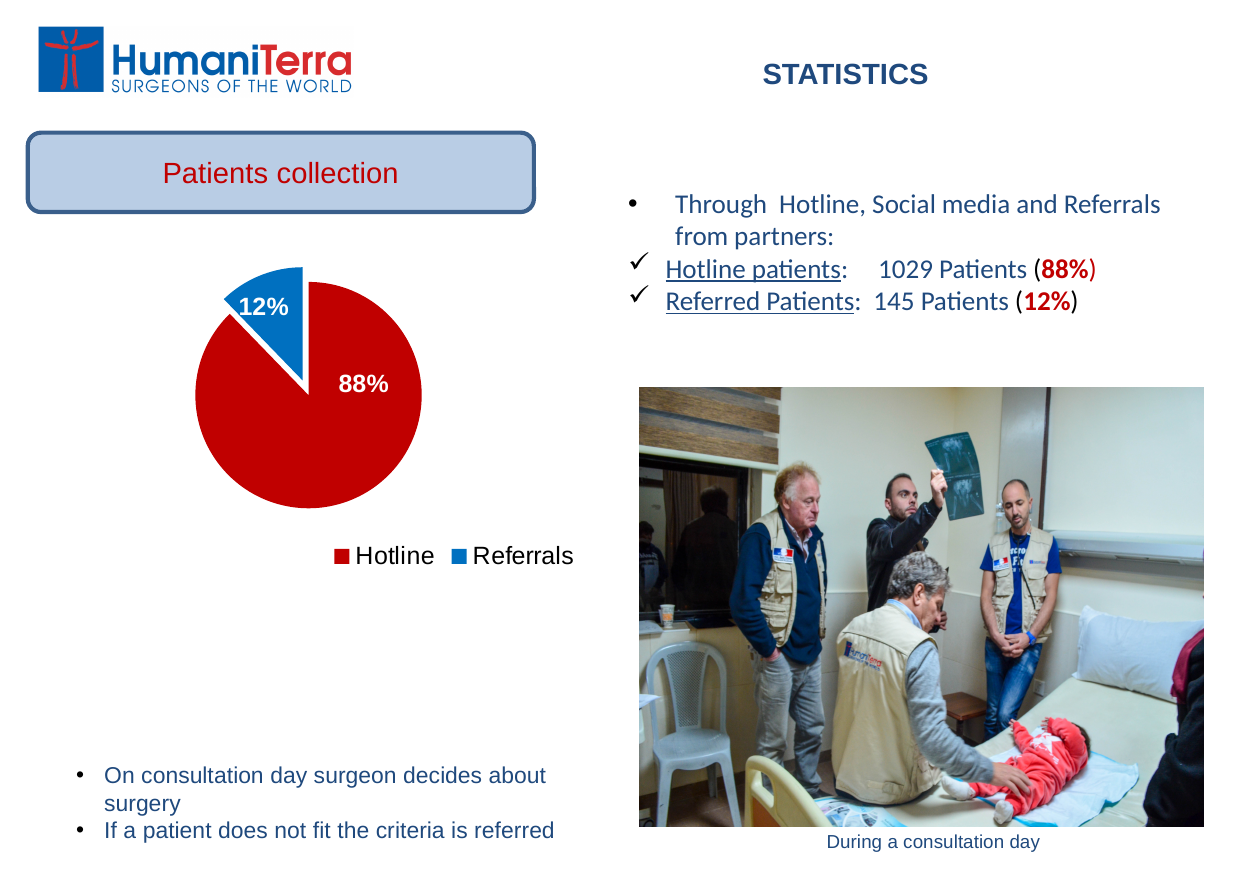
How many slices does the pie chart have? 2 Which slice of the pie is the largest? Hotline Which is larger, the Hotline slice or the Referrals slice? Hotline What colour is the Hotline slice? red How many entries does the legend list? 2 What is the difference in percentage points between the Hotline and Referrals slices? 76 What share of the pie does Hotline represent? 88% What share of the pie does Referrals represent? 12% Which slice of the pie is the smallest? Referrals What kind of chart is shown on the slide? pie chart What colour is the Referrals slice? blue